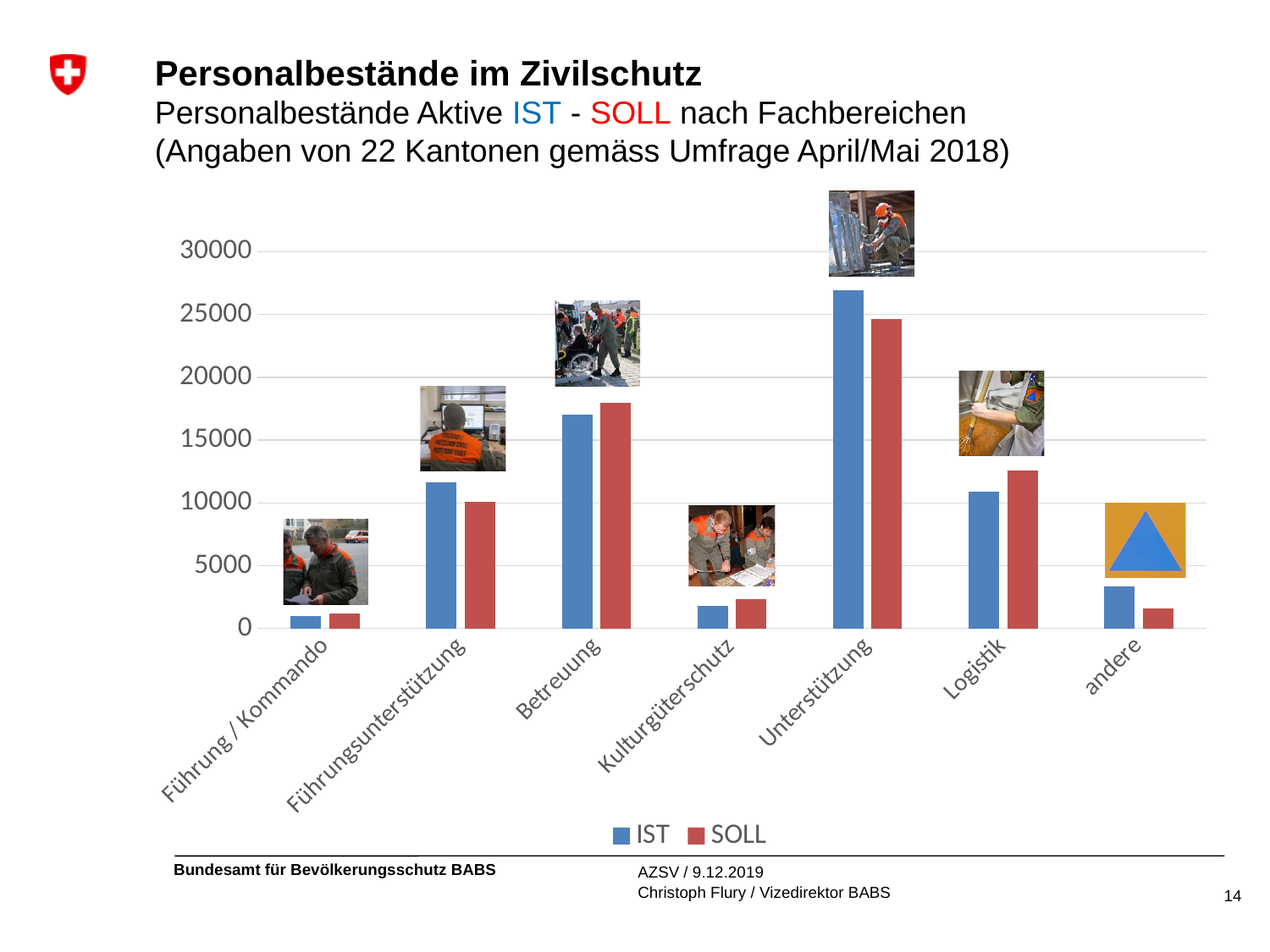
For andere, which is larger, IST or SOLL? IST For Unterstützung, which is larger, IST or SOLL? IST Which category has the highest SOLL value? Unterstützung Which category has the lowest IST value? Führung / Kommando How many categories (Fachbereiche) are shown on the x axis? 7 What kind of chart is shown on the slide? bar chart Which colour represents the SOLL series in the legend? red Which category has the highest IST value? Unterstützung Is the IST value for Unterstützung greater or less than 25000? greater How many series does the legend list? 2 For Logistik, which is larger, IST or SOLL? SOLL Is the SOLL value for Betreuung greater or less than 15000? greater